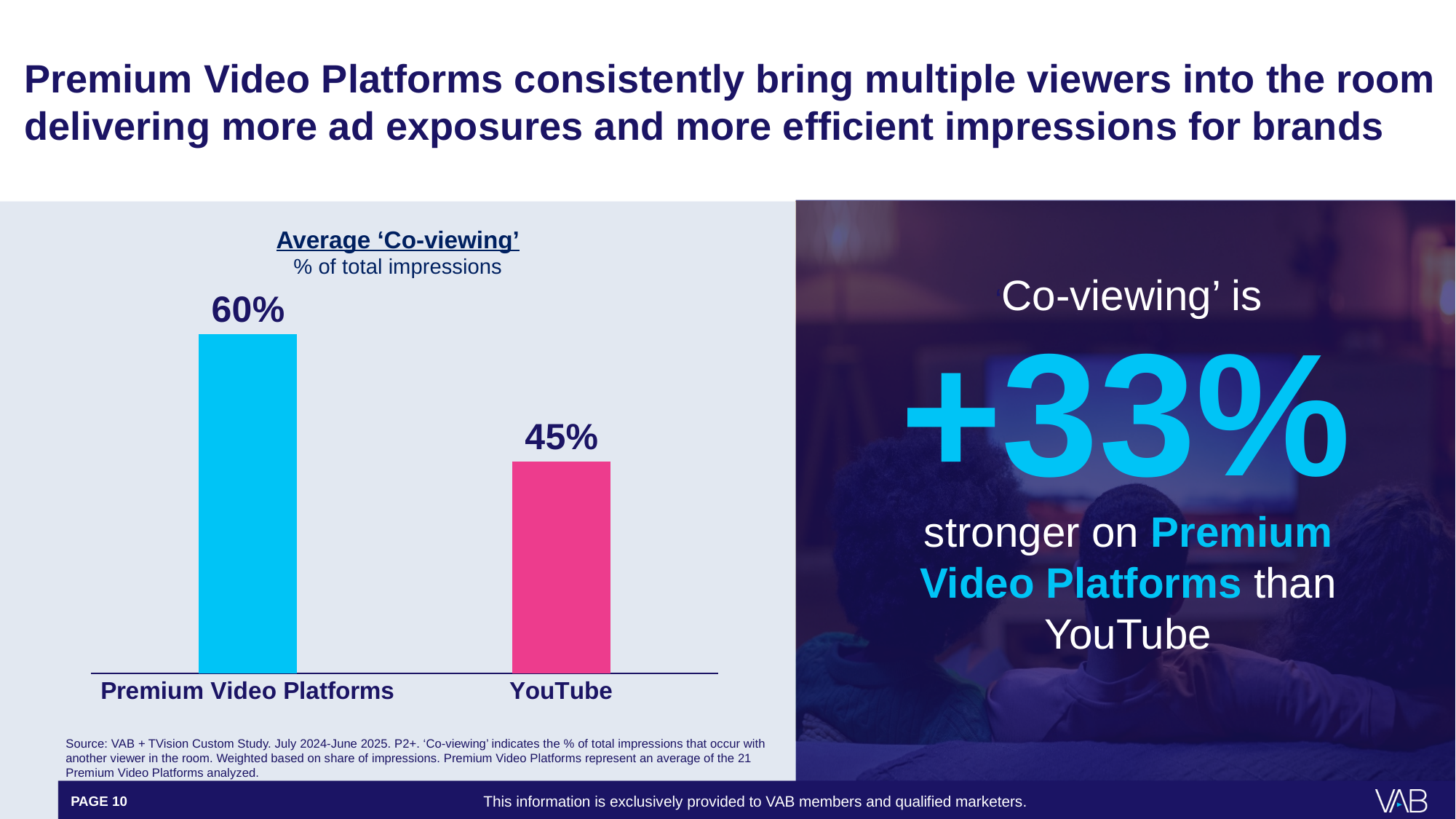
Which category has the lower average co-viewing percentage? YouTube What colour is the bar for YouTube? pink What is the average co-viewing percentage for Premium Video Platforms? 60% What unit does the chart subtitle say the values are measured in? % of total impressions What type of chart is shown on the slide? bar chart What is the average co-viewing percentage for YouTube? 45% How many categories are shown in the bar chart? 2 Is the co-viewing value for YouTube larger or smaller than the value for Premium Video Platforms? smaller What is the title of the chart? Average 'Co-viewing' Which category has the higher average co-viewing percentage? Premium Video Platforms What is the difference in percentage points between the co-viewing values for Premium Video Platforms and YouTube? 15 percentage points